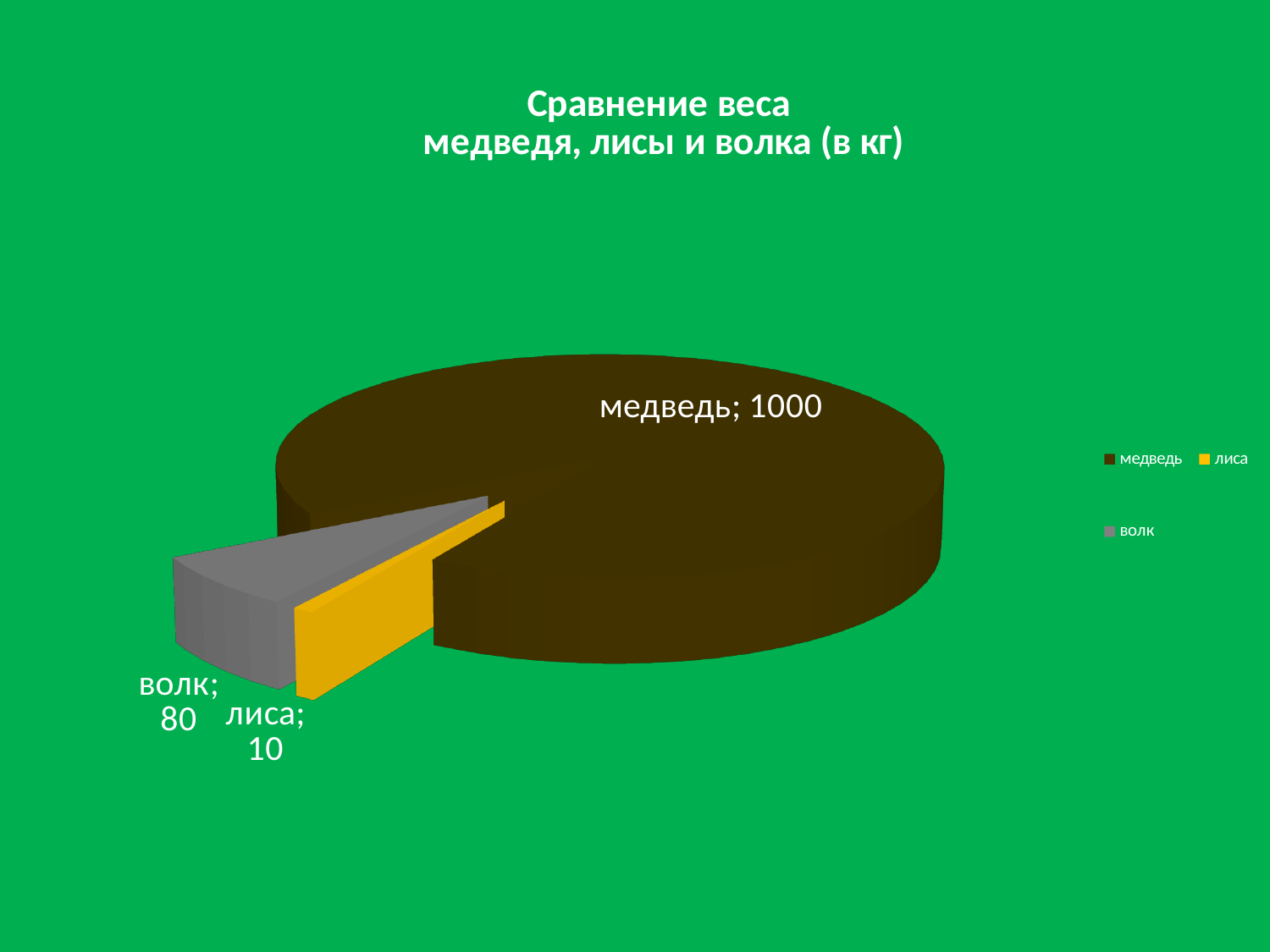
Which category has the largest slice in the pie chart? медведь What is the value for лиса in the pie chart? 10 Which is larger, the value for волк or the value for лиса? волк What is the difference between the values for медведь and волк? 920 What is the difference between the values for волк and лиса? 70 Which category has the smallest slice in the pie chart? лиса What is the title of the chart? Сравнение веса медведя, лисы и волка (в кг) How many slices does the pie chart have? 3 What kind of chart is shown on the slide? pie chart What is the value for волк in the pie chart? 80 What is the value for медведь in the pie chart? 1000 What is the total of all the values shown in the pie chart? 1090